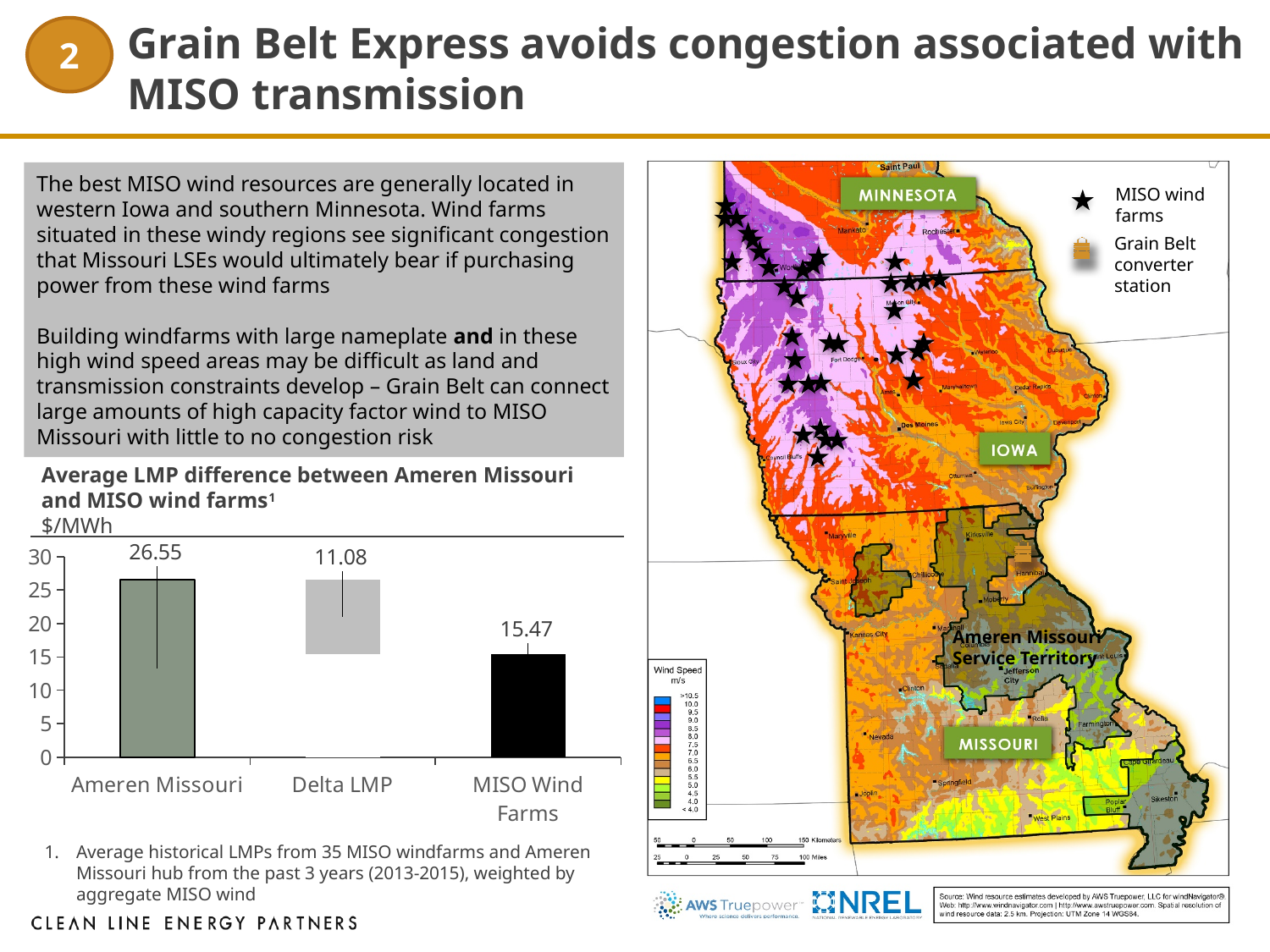
How many categories are shown on the x axis of the Average LMP difference chart? 3 What is the value for MISO Wind Farms in the Average LMP difference chart? 15.47 What is the value for Ameren Missouri in the Average LMP difference chart? 26.55 Which category has the lowest labelled value in the Average LMP difference chart? Delta LMP What is the value labelled for Delta LMP in the Average LMP difference chart? 11.08 Which is larger in the Average LMP difference chart, the value for Ameren Missouri or the value for MISO Wind Farms? Ameren Missouri What is the difference between the Ameren Missouri value and the MISO Wind Farms value in the Average LMP difference chart? 11.08 Which category has the highest value in the Average LMP difference chart? Ameren Missouri What unit is shown on the y axis of the Average LMP difference chart? $/MWh What kind of chart is the Average LMP difference chart? bar chart Is the value for MISO Wind Farms in the Average LMP difference chart greater or less than 20? less Is the value for Ameren Missouri in the Average LMP difference chart greater or less than 25? greater